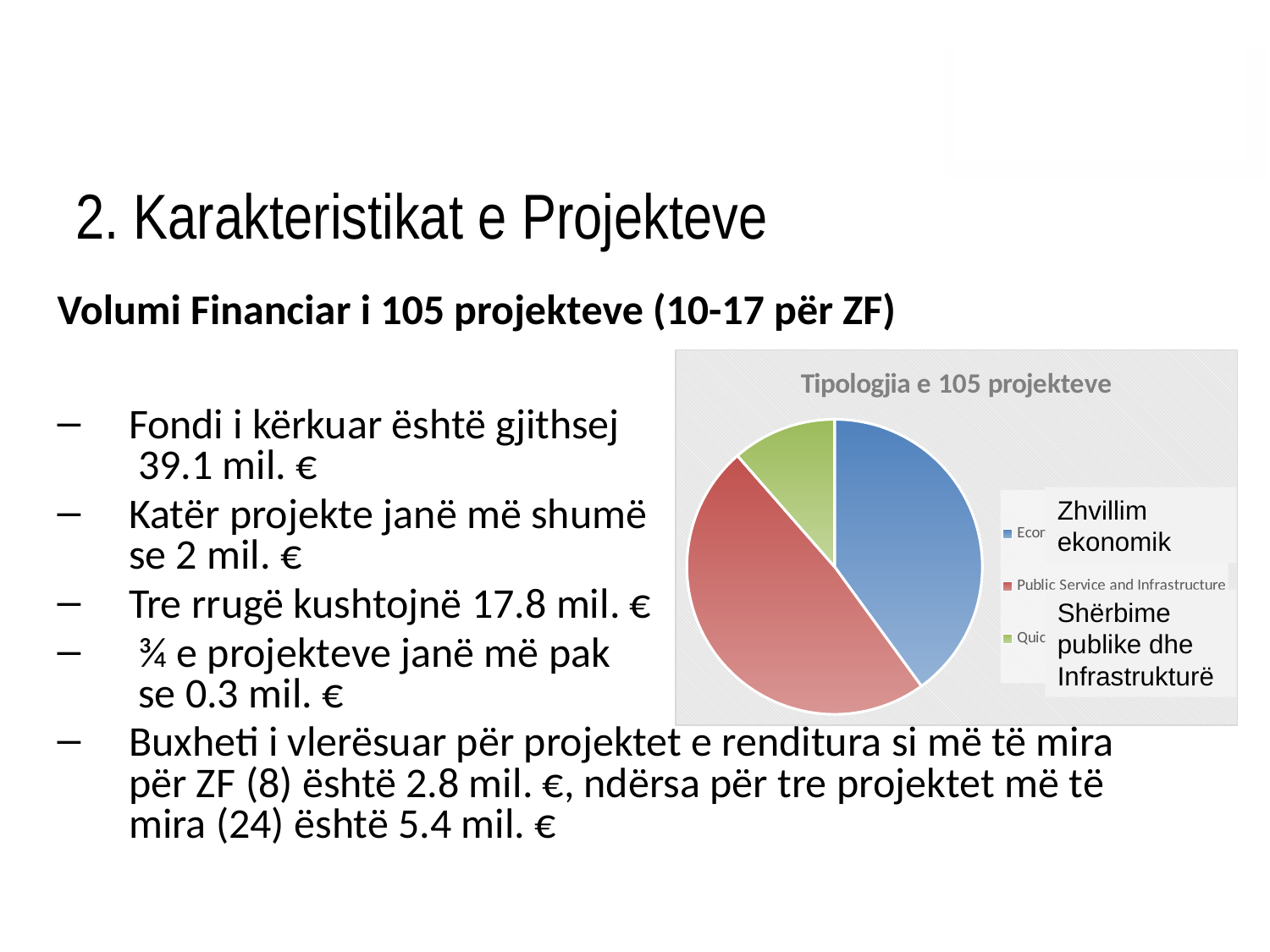
How many entries does the chart's legend list? 3 What colour is the Public Service and Infrastructure slice in the pie chart? red How many slices does the pie chart have? 3 Which colour is the smallest slice of the pie chart? green Which slice is larger in the pie chart, the red slice or the blue slice? the red slice What is the title of the chart on the slide? Tipologjia e 105 projekteve Which slice is larger in the pie chart, the blue slice or the green slice? the blue slice What kind of chart is shown on the slide? pie chart Which category has the largest slice of the pie chart? Public Service and Infrastructure